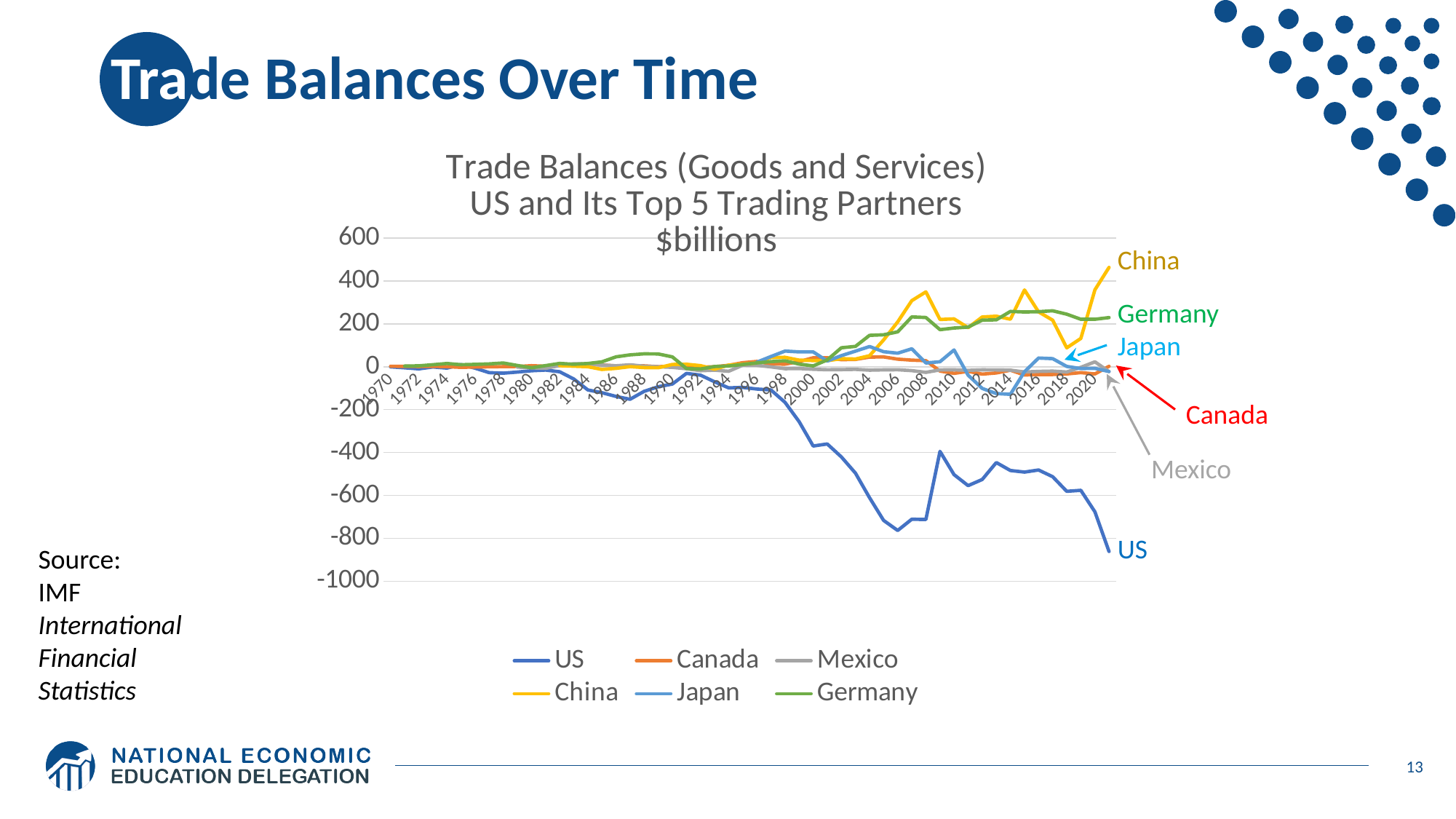
How many series does the legend list? 6 Is the US trade balance in 2006 greater or less than -600? less In 2020, which is larger, the trade balance of China or of Germany? China Which country has the highest trade balance at the end of the series (2020)? China What kind of chart is shown on the slide? line chart What unit is the trade balance measured in, according to the chart title? $billions Is Germany's trade balance in 2020 greater or less than 200? greater Which country has the lowest trade balance at the end of the series (2020)? US What is the title of the chart? Trade Balances (Goods and Services) US and Its Top 5 Trading Partners $billions Does the US trade balance line generally rise or fall from 1970 to 2020? fall